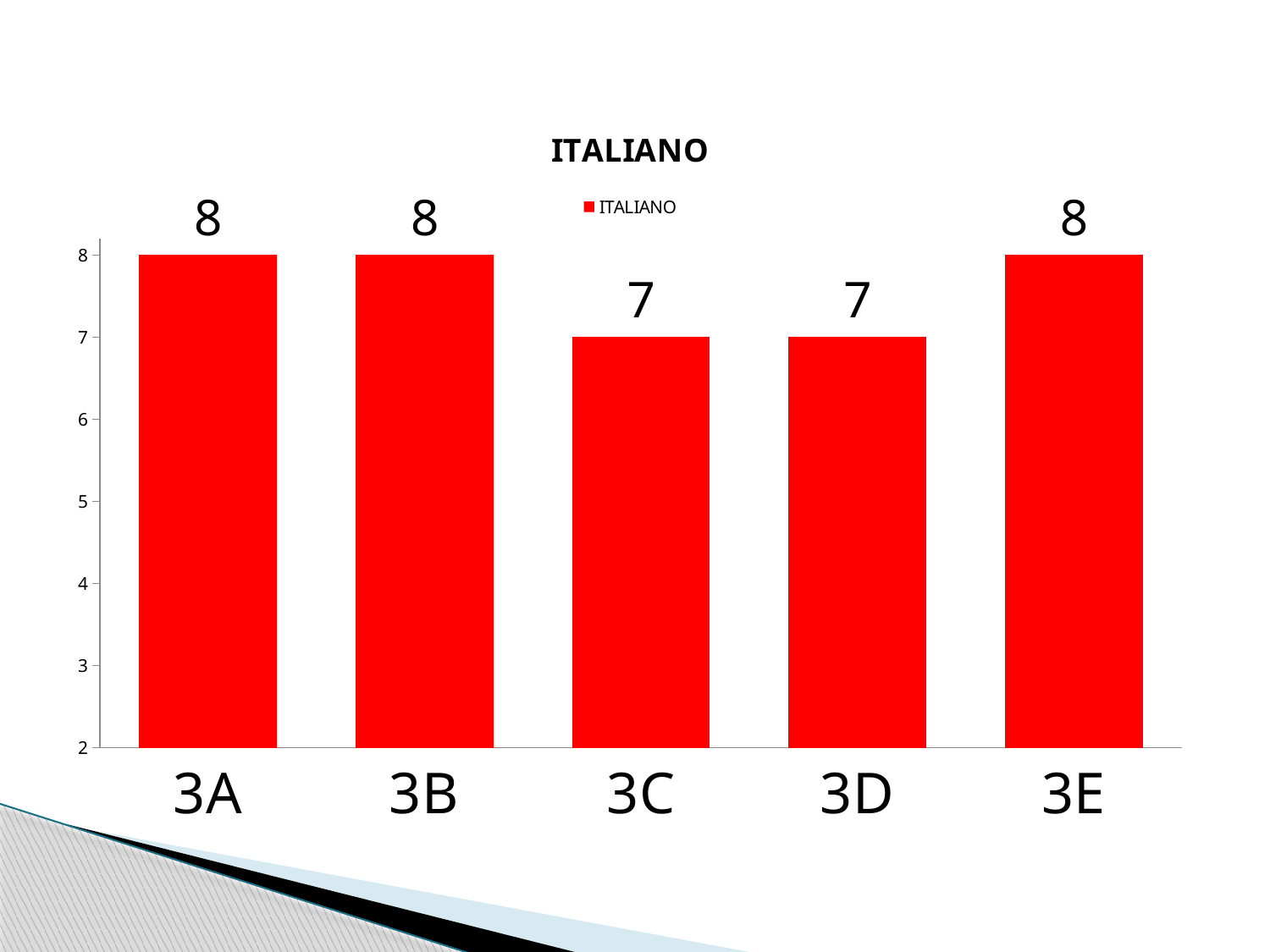
What is the value for 3A? 8 Which category has the lowest value, 3B or 3C? 3C What is the title of the chart? ITALIANO What is the value for 3E? 8 What is the value for 3D? 7 How many series does the legend list? 1 What colour are the bars? red How many categories are shown on the x axis? 5 What is the value for 3C? 7 What is the difference between the values for 3B and 3D? 1 What kind of chart is shown? bar chart Is the value for 3C greater or less than 8? less